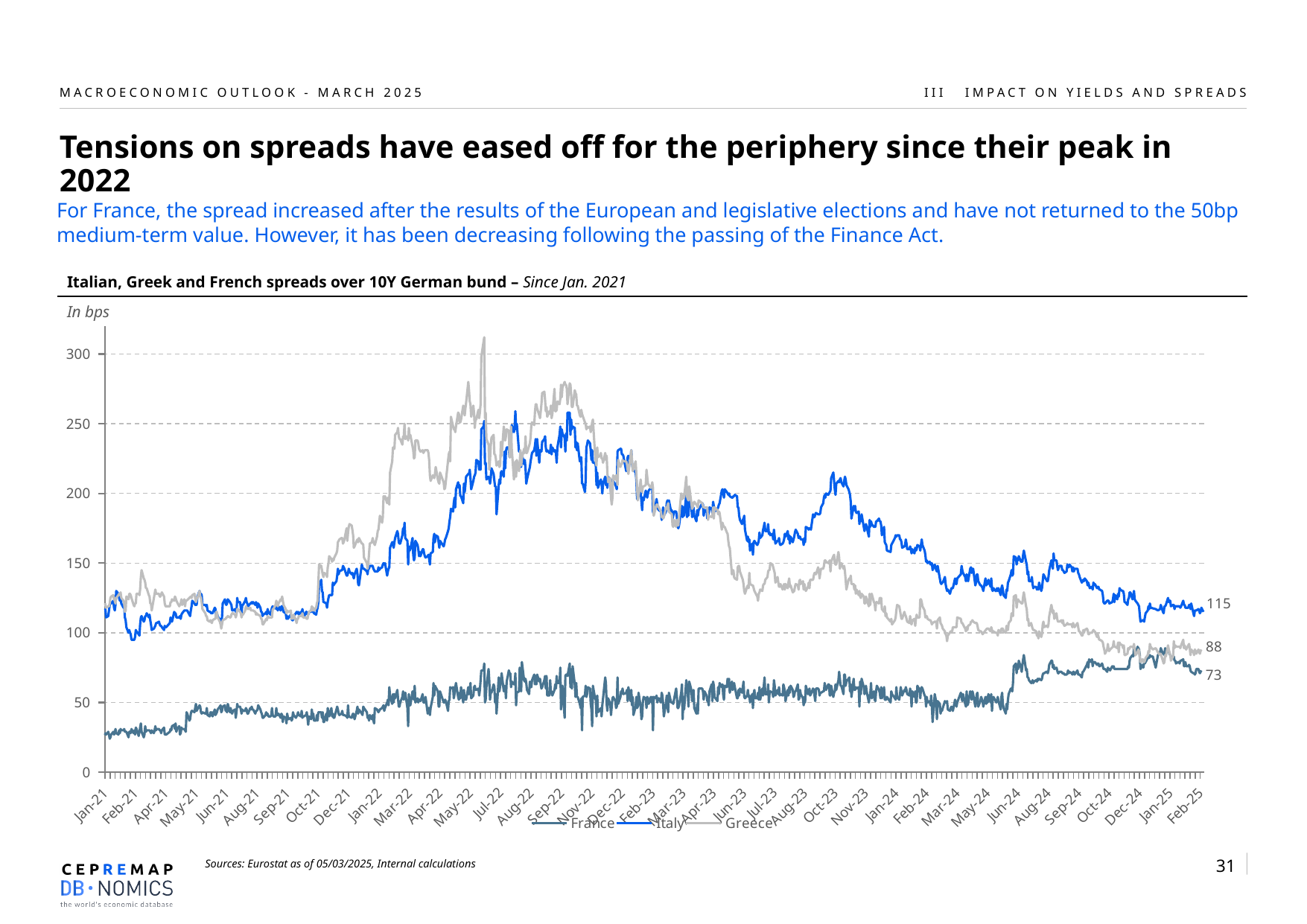
What kind of chart is shown on the slide? line chart Is the peak value of the Greece series greater or less than 250? greater What is the latest value shown for France at the end of the series? 73 Which series has the lowest value at the end of the chart (Feb-25)? France What is the latest value shown for Greece at the end of the series? 88 Does the Italy series rise or fall between Oct-23 and Feb-25? fall What is the latest value shown for Italy at the end of the series? 115 In what unit are the values on the chart expressed? bps Which series has the highest value at the end of the chart (Feb-25)? Italy What is the difference between the end values of Greece and France? 15 How many series does the legend list? 3 What is the difference between the end values of Italy and France? 42